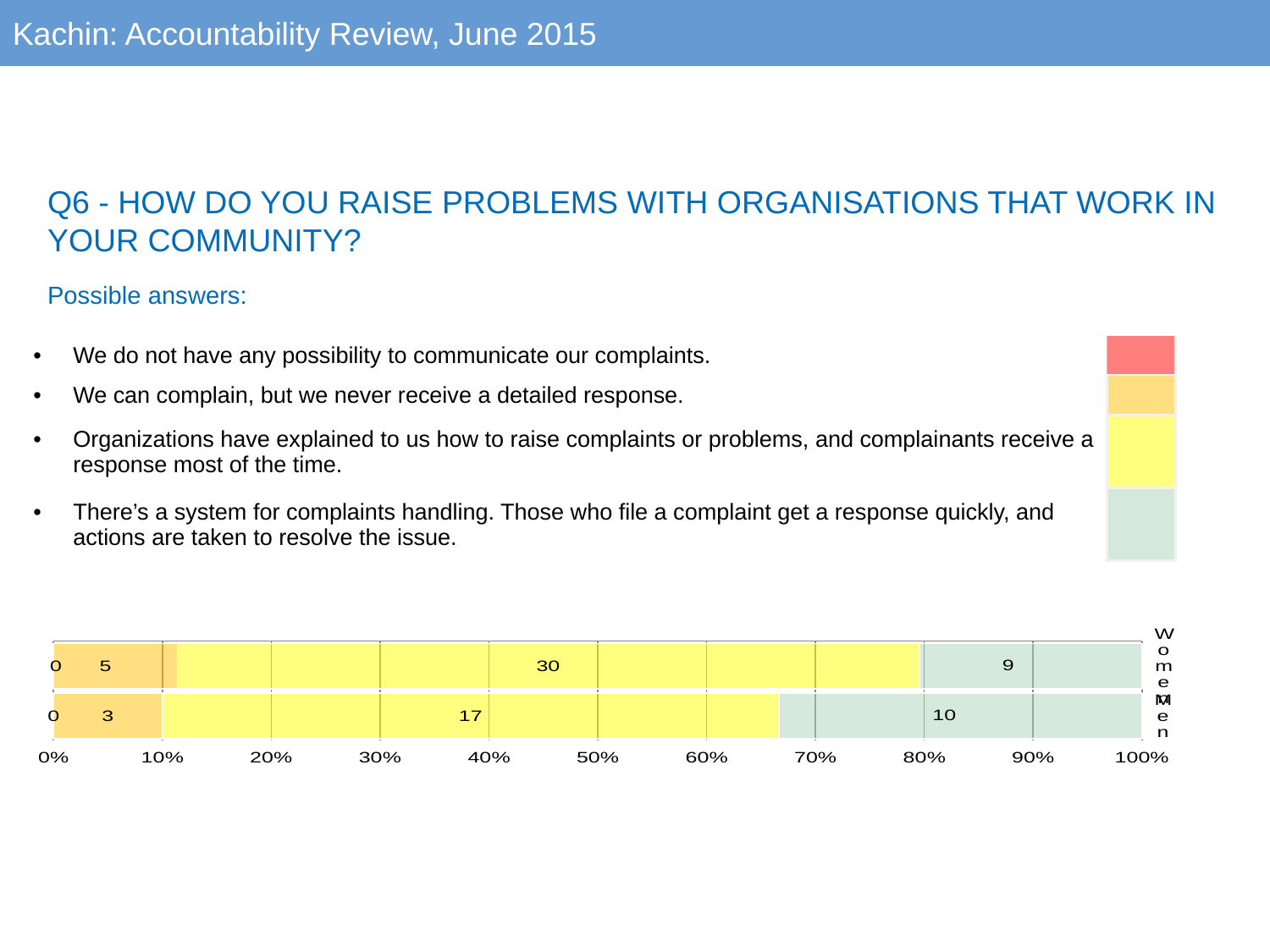
What is the value of the orange segment for Women? 5 Which has the larger green segment value, Women or Men? Men What is the value of the green segment for Men? 10 Does the yellow segment for Men end at a point greater or less than 60% on the axis? greater What is the value of the orange segment for Men? 3 What is the difference between the yellow segment values for Women and Men? 13 What kind of chart is shown at the bottom of the slide? bar chart What is the total of all segments in the Women bar? 44 What is the value of the red segment for Women? 0 What is the total of all segments in the Men bar? 30 What is the value of the yellow segment for Women? 30 How many categories (bars) does the chart show? 2